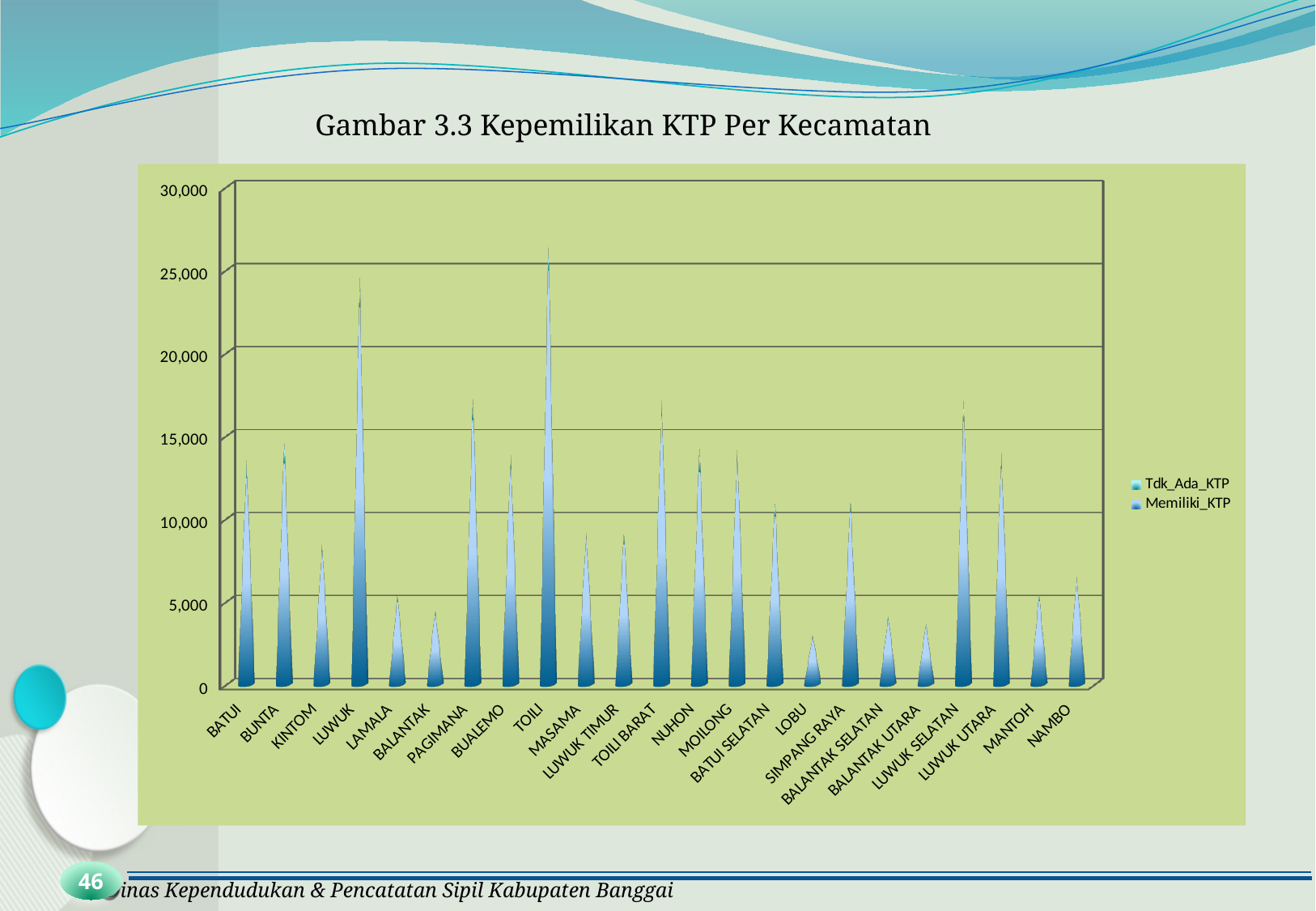
What is the title of the chart? Gambar 3.3 Kepemilikan KTP Per Kecamatan What are the two series named in the legend? Tdk_Ada_KTP and Memiliki_KTP Is the value for TOILI greater or less than 25,000? greater What kind of chart is shown on the slide? bar chart Is the value for BATUI greater or less than 10,000? greater Which is larger, the value for BATUI or the value for KINTOM? BATUI How many series does the legend list? 2 Which is larger, the value for TOILI or the value for LUWUK? TOILI Is the value for LUWUK greater or less than 20,000? greater Which kecamatan has the highest value? TOILI How many kecamatan (categories) are shown on the x axis? 23